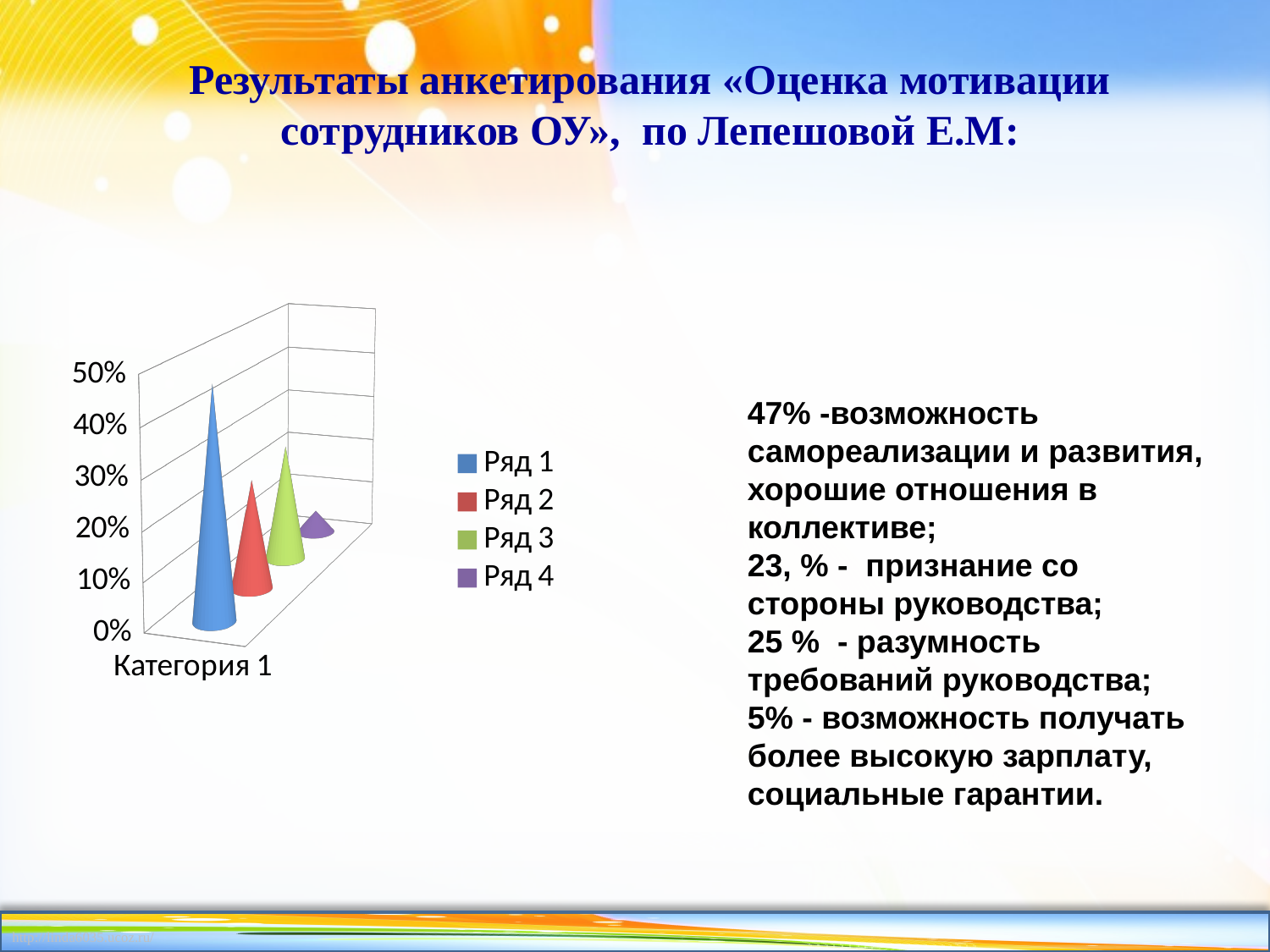
Which series has the lowest value in the chart? Ряд 4 Is the value for Ряд 4 greater or less than 10%? less How many series does the chart legend list? 4 Is the value for Ряд 1 greater or less than 40%? greater Is the value for Ряд 3 greater or less than 40%? less What is the label of the category on the chart's x axis? Категория 1 How many categories are shown on the chart's x axis? 1 Which series has the highest value in the chart? Ряд 1 What kind of chart is shown on the slide? bar chart Which is larger, the value for Ряд 1 or the value for Ряд 4? Ряд 1 Which is larger, the value for Ряд 2 or the value for Ряд 1? Ряд 1